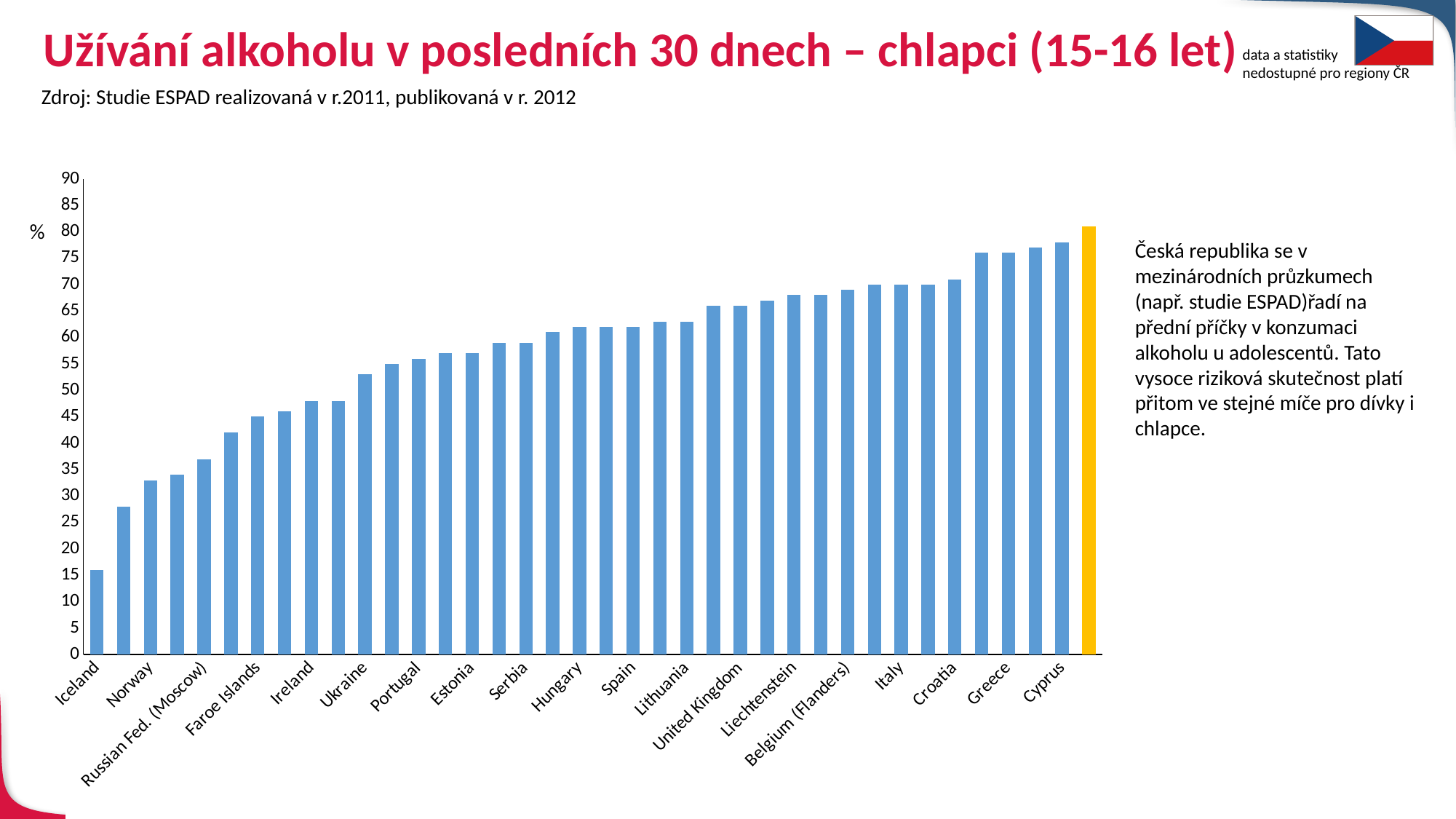
Is the value for Liechtenstein greater or less than 65? greater Is the value for Cyprus greater or less than 75? greater Is the value for Iceland greater or less than 20? less Do the values generally rise or fall from left to right along the x axis? rise Which has the larger value, Iceland or Norway? Norway What kind of chart is shown on the slide? bar chart What unit is shown on the vertical axis of the chart? %